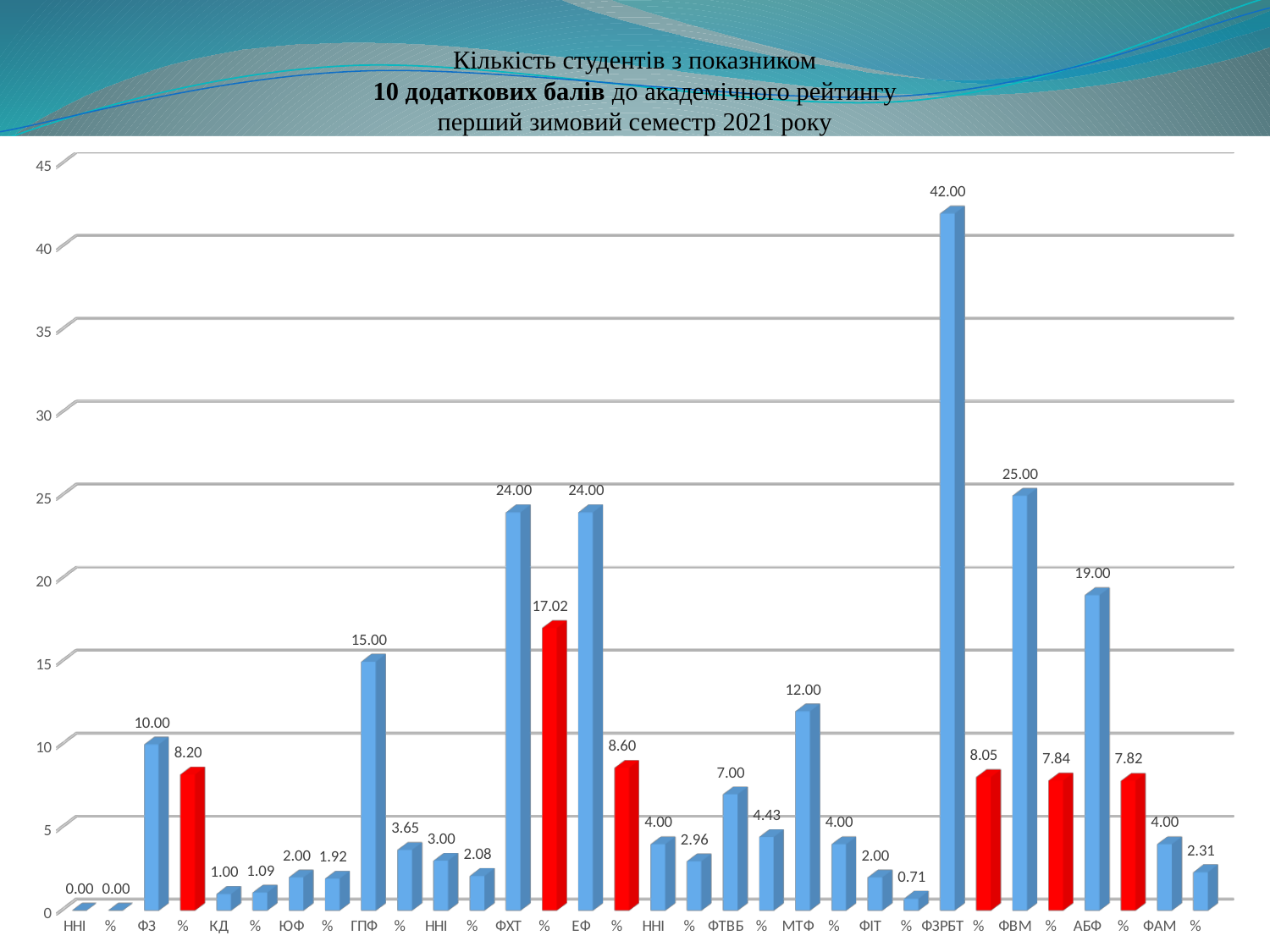
Is the value for ФЗРБТ greater or less than 40? greater How many bars on the chart are coloured red? 6 What is the value of the bar for ГПФ? 15.00 What is the difference between the bars for ФХТ and ЕФ? 0.00 What is the value of the bar for ФВМ? 25.00 What is the value of the red percentage bar immediately to the right of ФХТ? 17.02 What kind of chart is shown on the slide? bar chart Which category has the highest bar on the chart? ФЗРБТ What is the value of the bar for ФЗРБТ? 42.00 Is the value for АБФ greater or less than 20? less Which is larger, the bar for ГПФ or the bar for МТФ? ГПФ What is the difference between the bars for ФЗРБТ and ФВМ? 17.00